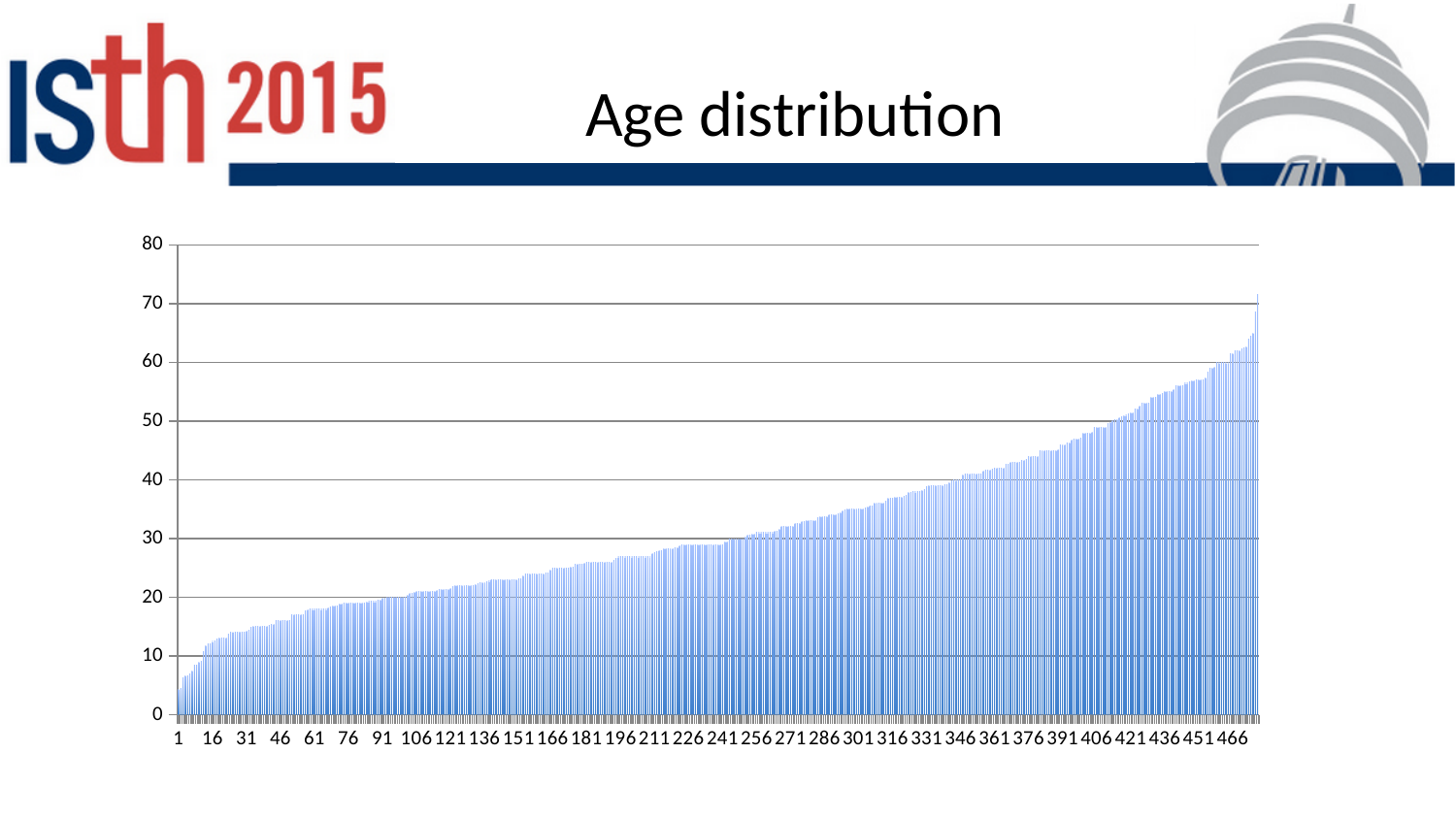
What is the title of the chart? Age distribution Is the value for category 301 greater or less than 30? greater Which is larger, the value for category 46 or the value for category 376? 376 Is the value for category 196 greater or less than 30? less What kind of chart is shown on the slide? bar chart What is the highest value shown on the y axis? 80 Is the value for category 1 greater or less than 10? less Do the values rise or fall from left to right along the x axis? rise